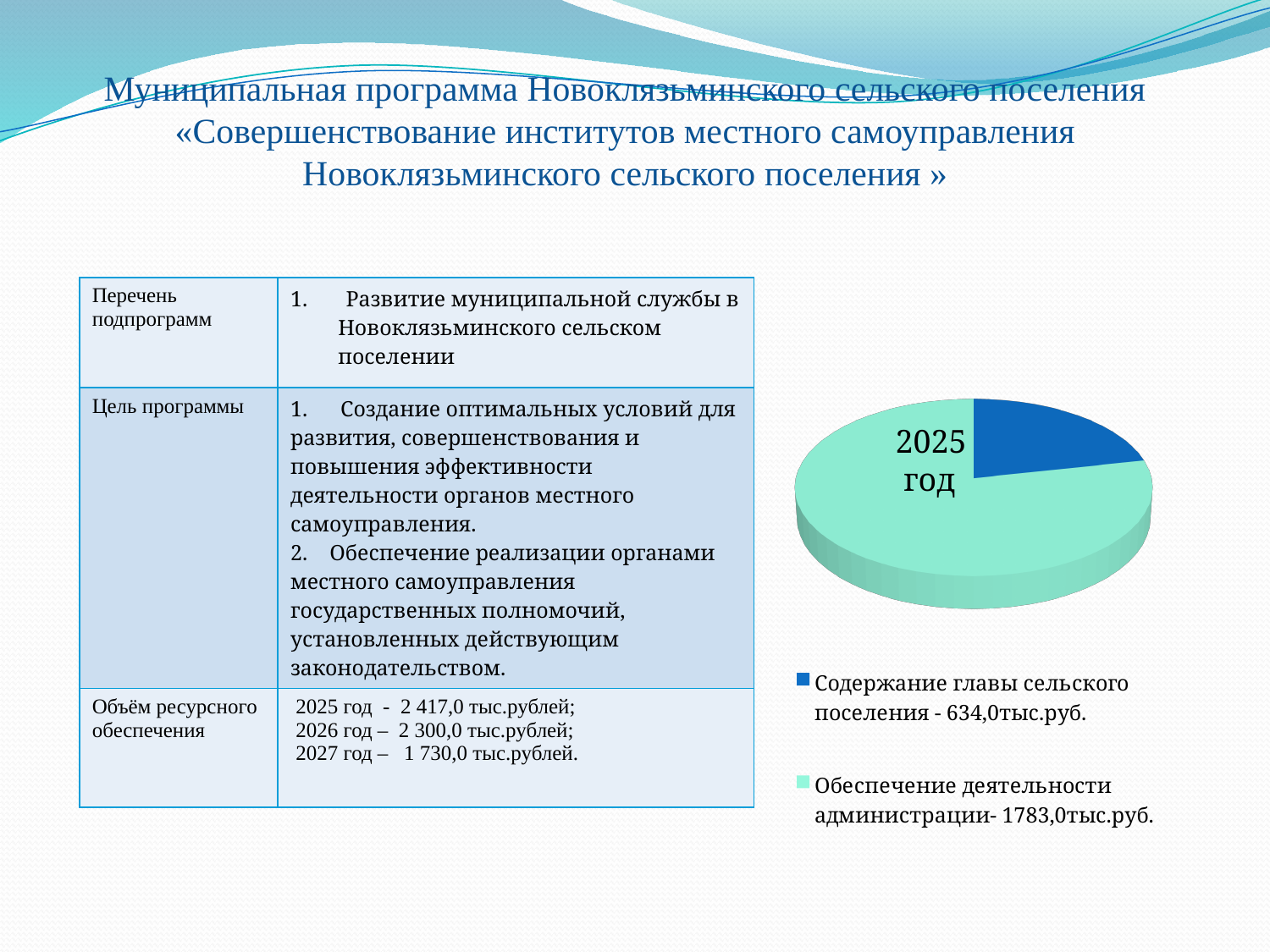
What value does the legend give for "Обеспечение деятельности администрации"? 1783,0тыс.руб. Which is larger in the pie chart: "Содержание главы сельского поселения" or "Обеспечение деятельности администрации"? Обеспечение деятельности администрации What year label is printed on the pie chart? 2025 год What kind of chart is shown on the slide? pie chart What colour is the slice for "Содержание главы сельского поселения" in the pie chart? dark blue Which category has the largest slice of the pie chart? Обеспечение деятельности администрации How many entries does the legend of the pie chart list? 2 Which category has the smallest slice of the pie chart? Содержание главы сельского поселения What value does the legend give for "Содержание главы сельского поселения"? 634,0тыс.руб. What is the total of the two values shown in the pie chart legend? 2417,0 тыс.руб. By how much does "Обеспечение деятельности администрации" exceed "Содержание главы сельского поселения" in the pie chart? 1149,0 тыс.руб. How many slices does the pie chart have? 2